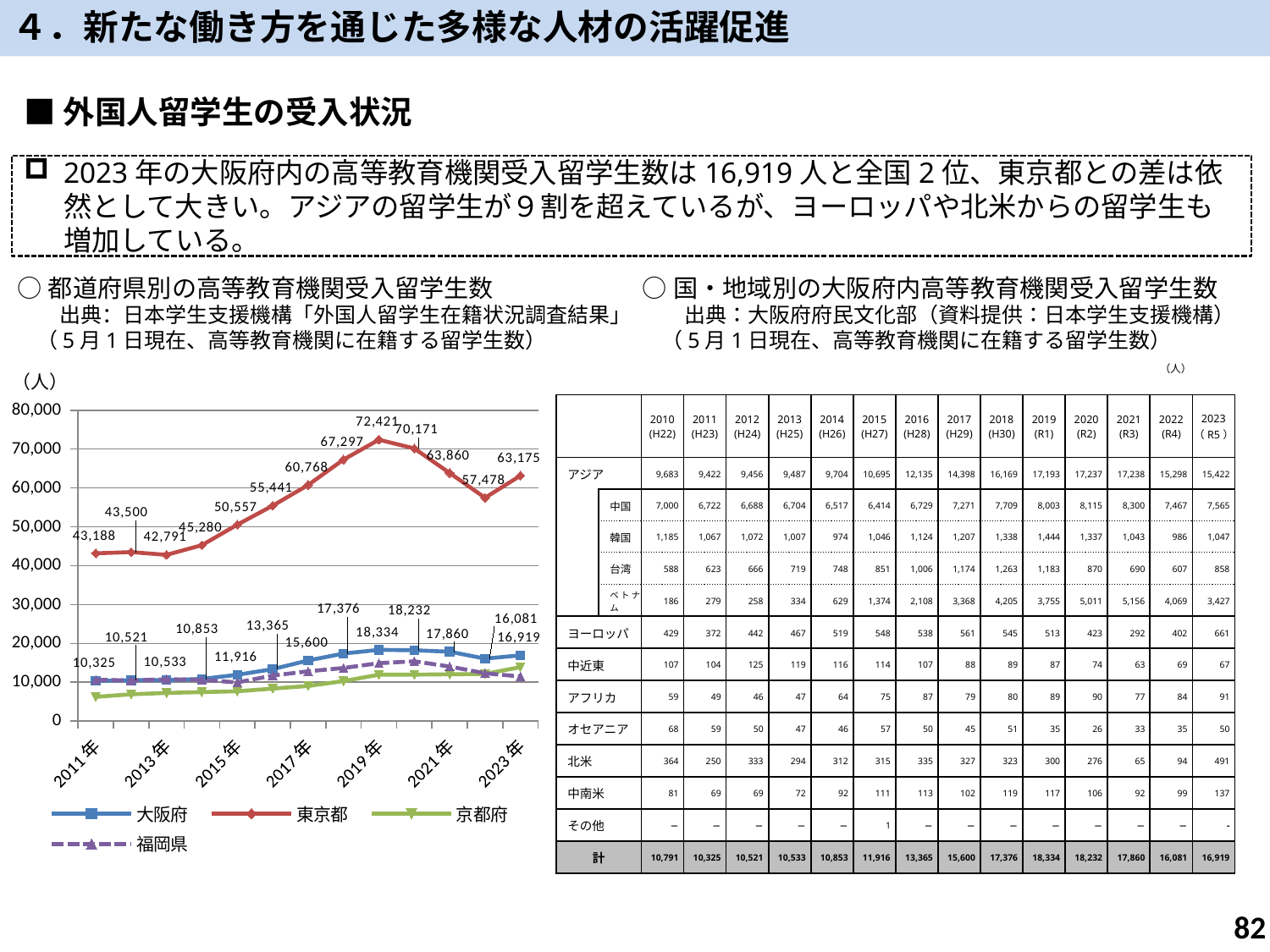
In the line chart, is the value for 京都府 in 2023年 greater or less than 20,000? less In the line chart, what is the value for 大阪府 in 2023年? 16,919 In the line chart, what is the value for 東京都 in 2019年? 72,421 How many series does the legend of the line chart list? 4 In the line chart, what is the difference between 東京都 and 大阪府 in 2023年? 46,256 In the line chart, by how much did the value for 東京都 increase from 2022年 to 2023年? 5,697 In the line chart, does the value for 東京都 rise or fall from 2013年 to 2019年? rise In the line chart, in which year is the value for 大阪府 lowest? 2011年 In the line chart, which is larger for 大阪府: the value in 2019年 or the value in 2023年? 2019年 What kind of chart is shown on the left of the slide? line chart In the line chart, in which year does 東京都 reach its highest value? 2019年 In the line chart, what is the value for 東京都 in 2011年? 43,188